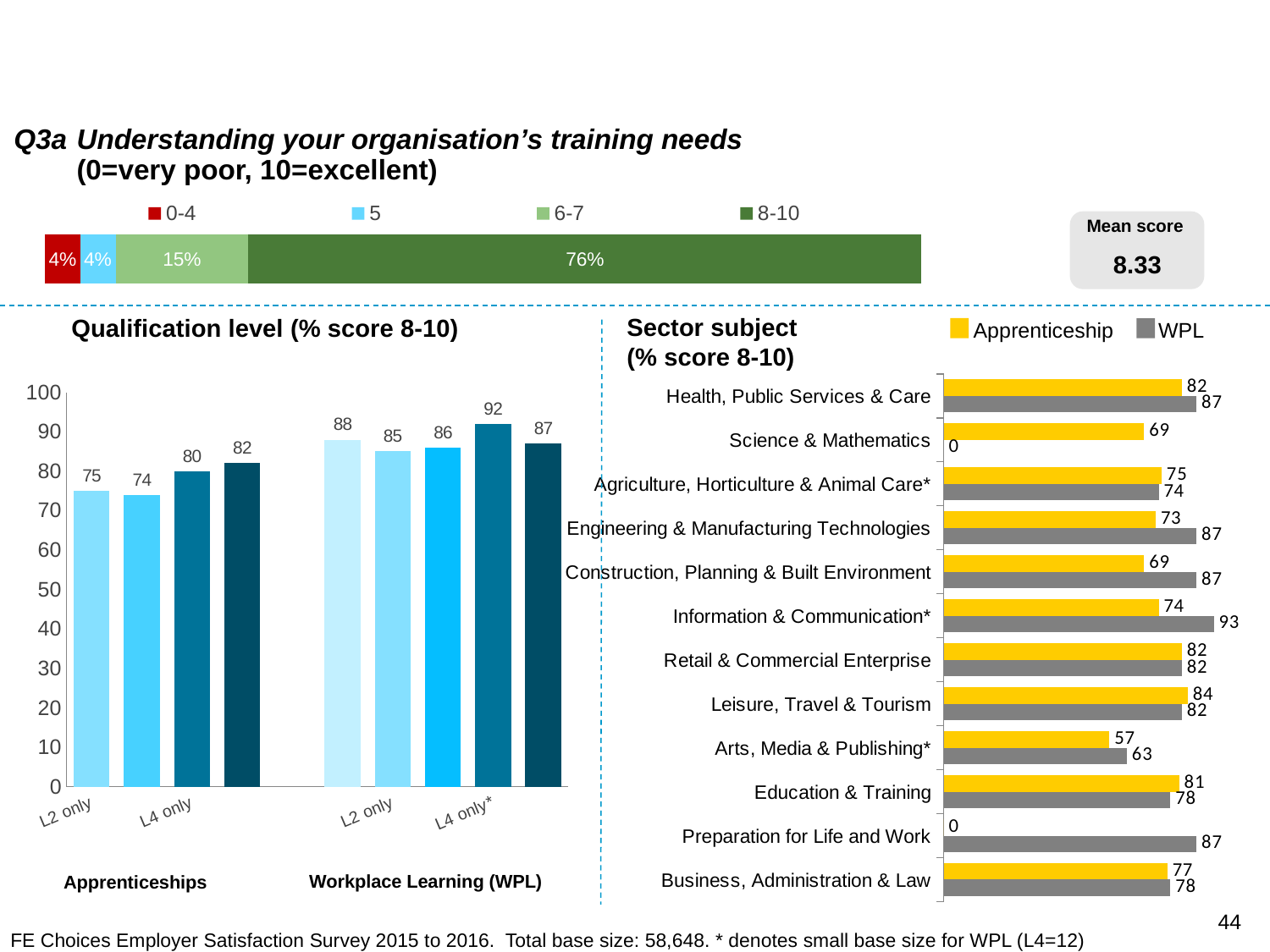
In the Sector subject chart, which is larger for Leisure, Travel & Tourism: the Apprenticeship value or the WPL value? Apprenticeship In the Sector subject chart, which sector has the lowest WPL value? Science & Mathematics What is the highest value shown in the Qualification level (% score 8-10) chart? 92 How many series does the legend of the Sector subject chart list? 2 In the stacked bar at the top of the slide, what percentage gave a score of 8-10? 76% In the Sector subject chart, what is the WPL value for Science & Mathematics? 0 How many sector subjects are listed in the Sector subject chart? 12 In the Sector subject chart, which sector has the highest WPL value? Information & Communication* In the Sector subject chart, what is the WPL value for Information & Communication*? 93 In the Sector subject chart, what is the Apprenticeship value for Health, Public Services & Care? 82 What kind of chart is the Qualification level (% score 8-10) chart? bar chart In the Sector subject chart, what is the difference between the WPL and Apprenticeship values for Engineering & Manufacturing Technologies? 14